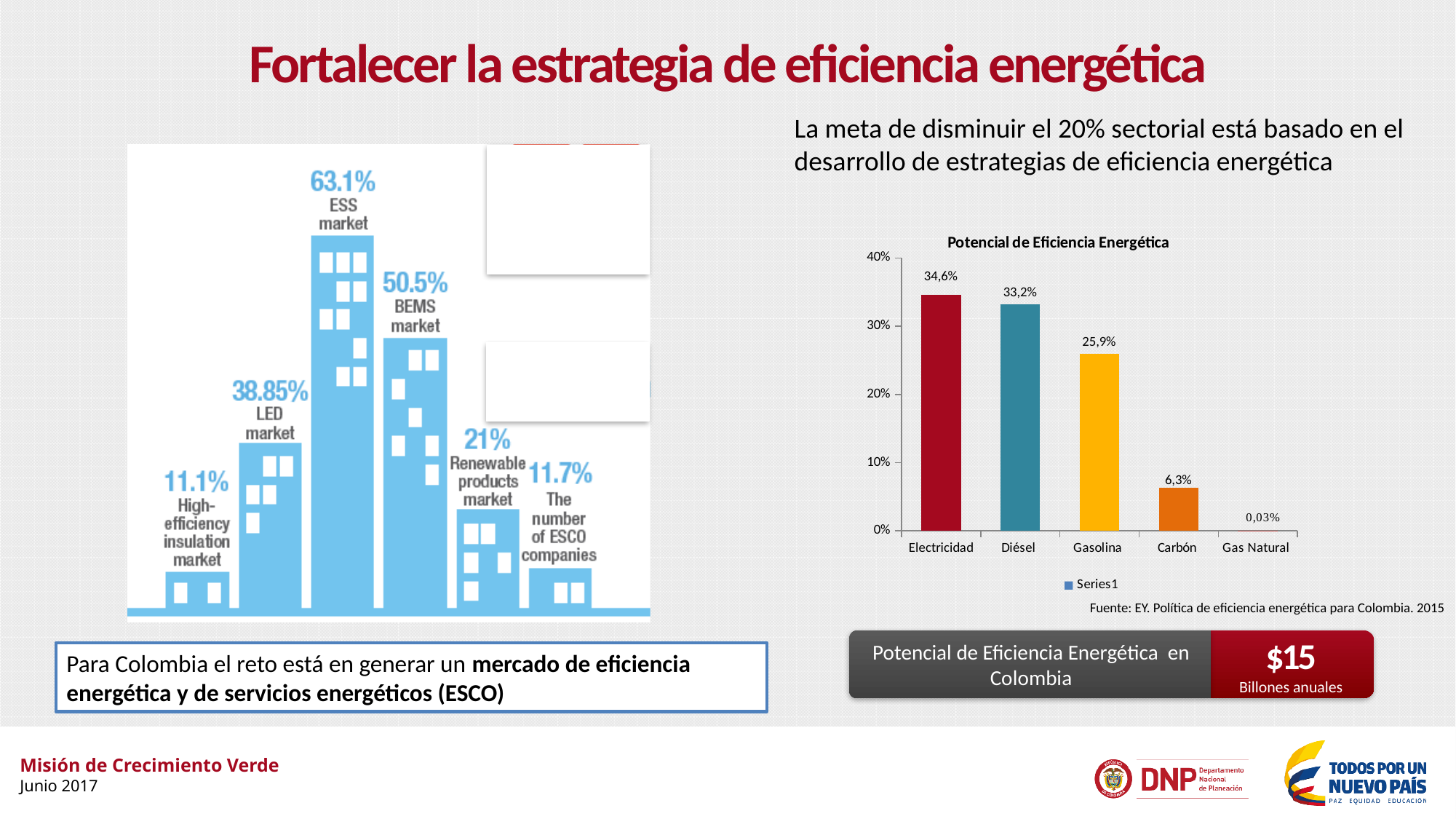
In the 'Potencial de Eficiencia Energética' chart, how many series does the legend list? 1 In the infographic on the left of the slide, what is the difference between the ESS market and the BEMS market? 12.6% In the infographic on the left of the slide, what is the value for the ESS market? 63.1% In the 'Potencial de Eficiencia Energética' chart, what is the value for Electricidad? 34,6% In the 'Potencial de Eficiencia Energética' chart, which category has the lowest value? Gas Natural In the 'Potencial de Eficiencia Energética' chart, what is the value for Gas Natural? 0,03% What kind of chart is the 'Potencial de Eficiencia Energética' chart? Bar chart In the 'Potencial de Eficiencia Energética' chart, how many categories are shown on the x axis? 5 In the 'Potencial de Eficiencia Energética' chart, what is the difference between Gasolina and Carbón? 19,6% In the 'Potencial de Eficiencia Energética' chart, do the values rise or fall from Electricidad to Gas Natural? Fall In the 'Potencial de Eficiencia Energética' chart, which is larger, Diésel or Gasolina? Diésel In the 'Potencial de Eficiencia Energética' chart, which category has the highest value? Electricidad